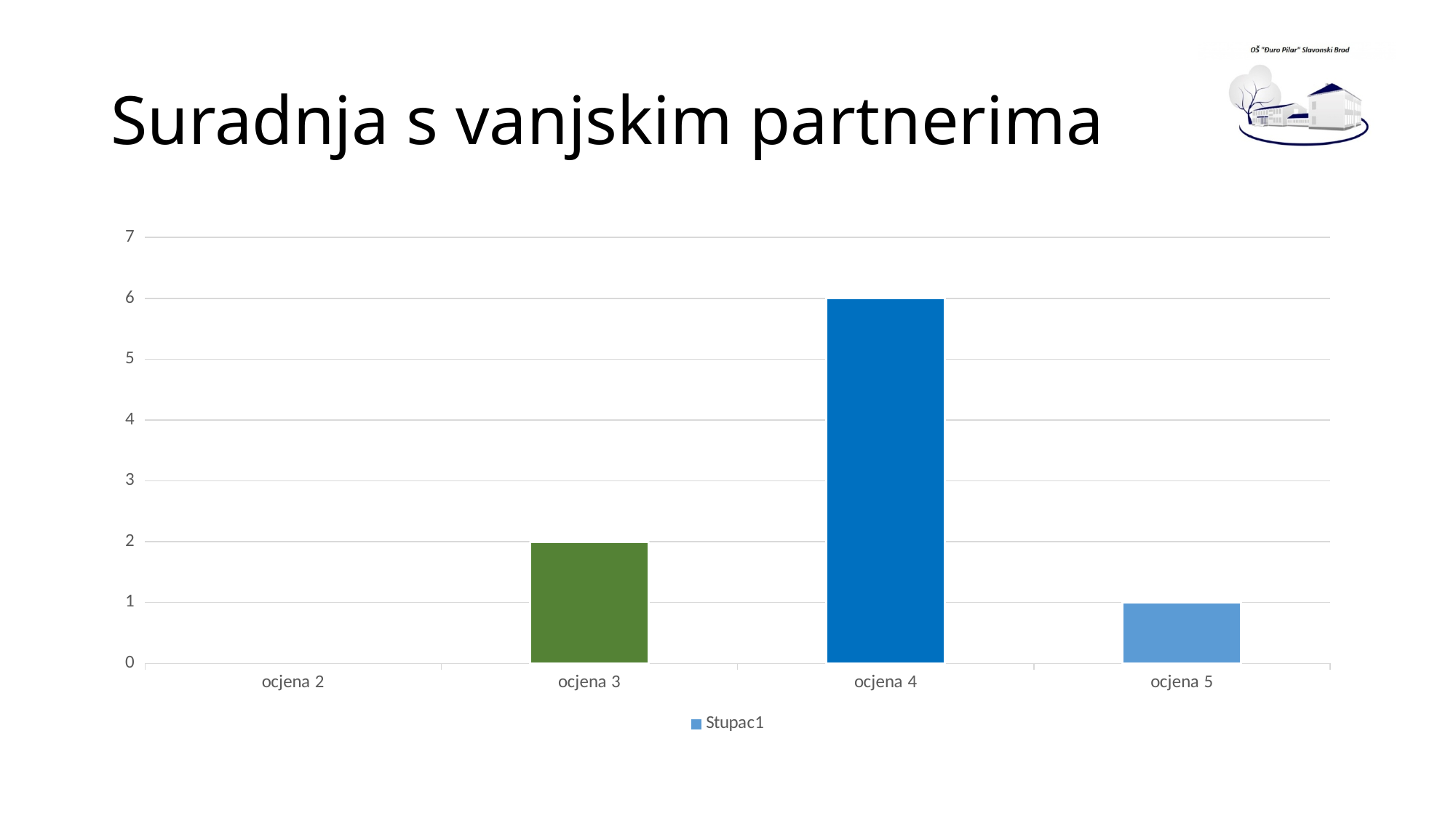
Which category has the highest value? ocjena 4 How many categories are shown on the x axis of the chart? 4 How many series does the chart legend list? 1 Is the value for ocjena 4 greater or less than 5? greater What is the value for ocjena 3? 2 Which category with a visible bar has the lowest value? ocjena 5 What is the value for ocjena 4? 6 Which is larger, the value for ocjena 3 or the value for ocjena 5? ocjena 3 What kind of chart is shown on the slide? bar chart What is the name of the series shown in the chart legend? Stupac1 What is the value for ocjena 5? 1 What is the difference between the values for ocjena 4 and ocjena 3? 4